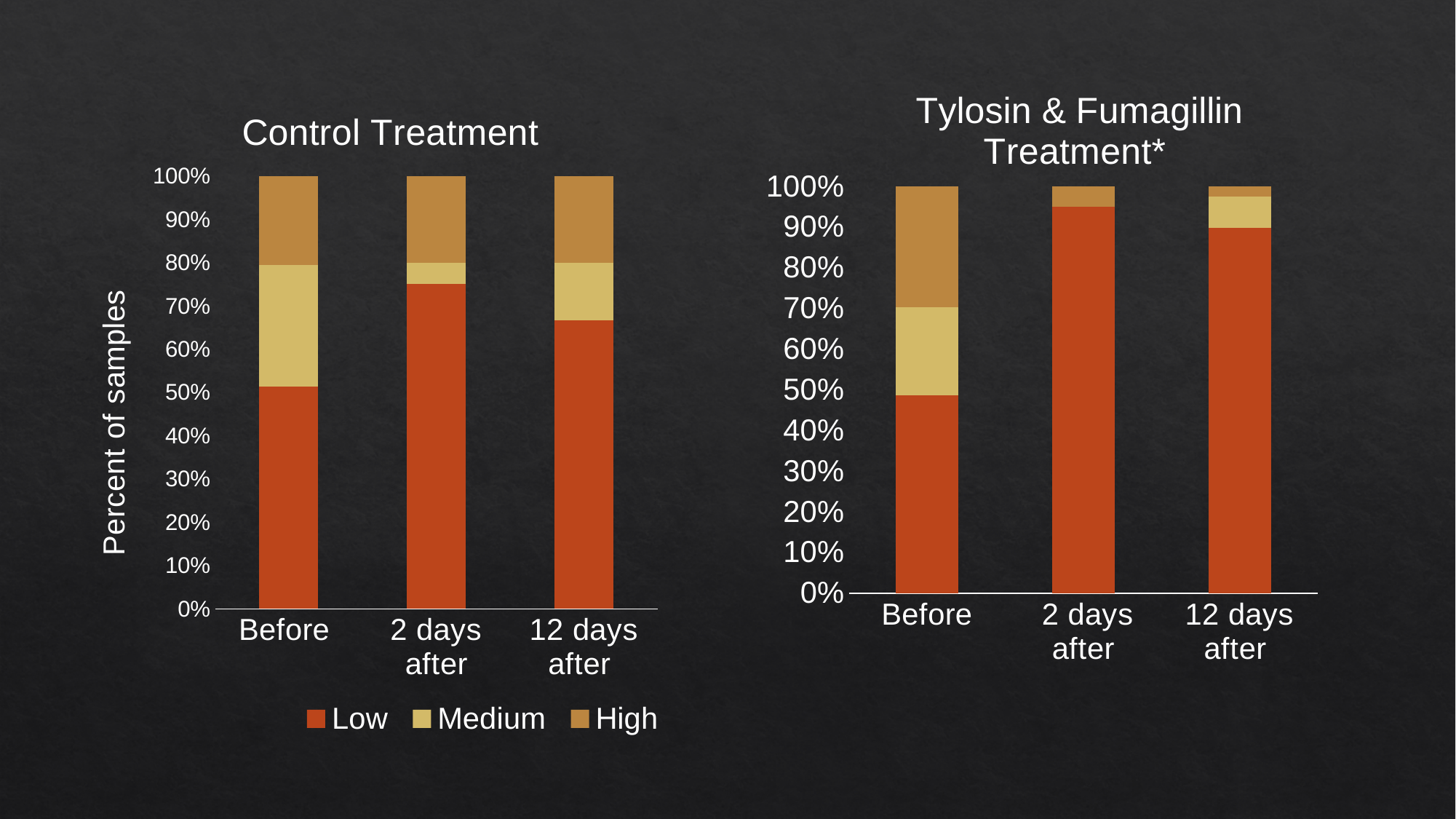
What kind of chart is the Control Treatment chart? Stacked bar chart Which is larger: the Low share for 12 days after in the Control Treatment chart or the Low share for 12 days after in the Tylosin & Fumagillin Treatment* chart? Tylosin & Fumagillin Treatment* How many series does the legend list for the Control Treatment chart? 3 In the Control Treatment chart, is the Low value for 2 days after greater or less than 70%? greater In the Control Treatment chart, which category has the smallest Medium share? 2 days after In the Tylosin & Fumagillin Treatment* chart, is the Low value for Before greater or less than 60%? less How many categories are shown on the x axis of the Tylosin & Fumagillin Treatment* chart? 3 In the Tylosin & Fumagillin Treatment* chart, what is the total of the stacked Before bar? 100% In the Control Treatment chart, is the Low value for Before greater or less than 60%? less What is the y-axis label on the Control Treatment chart? Percent of samples In the Control Treatment chart, which category has the largest Low share? 2 days after